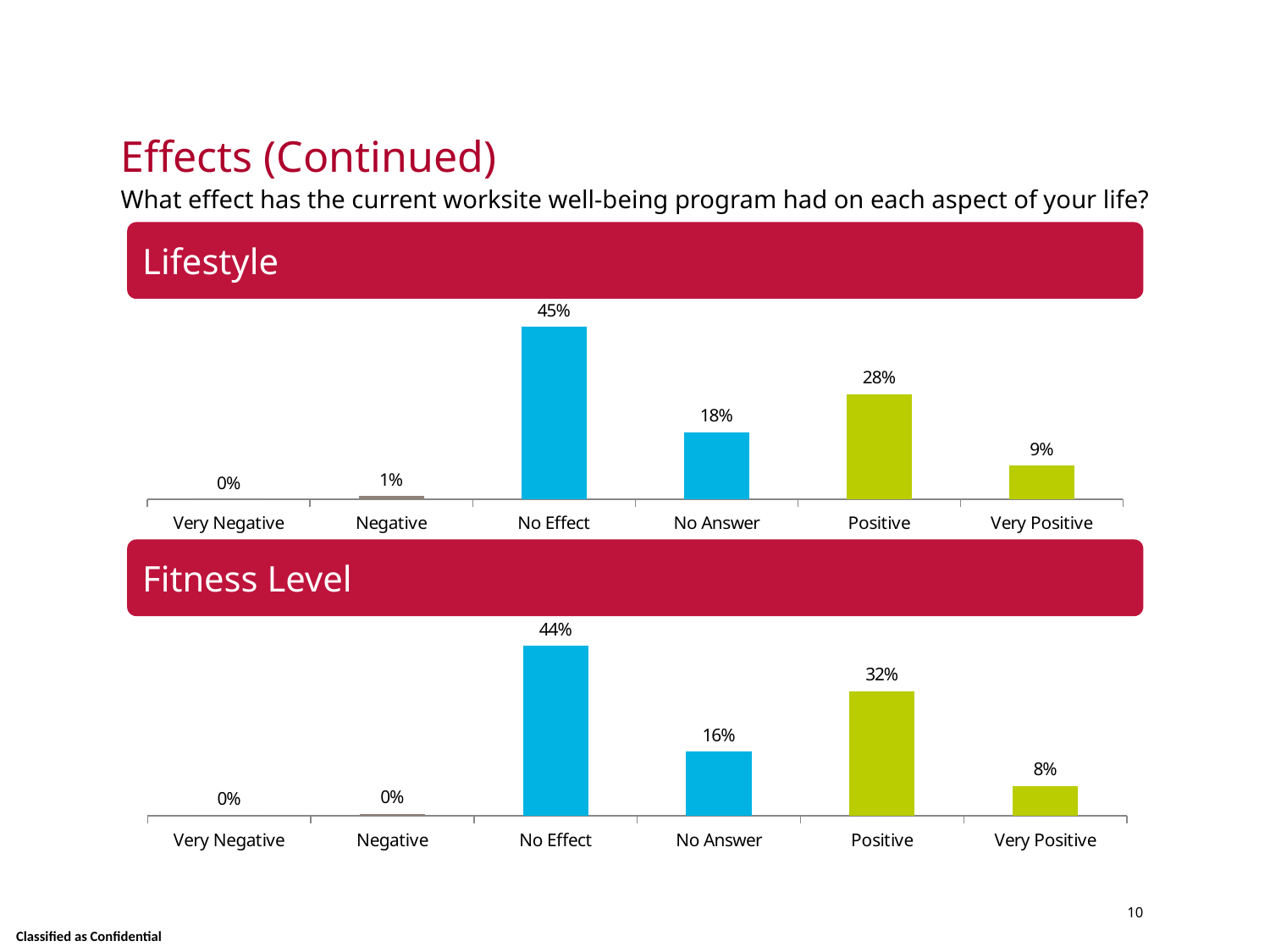
What type of chart is the Fitness Level chart? Bar chart In the Fitness Level chart, what is the value for No Answer? 16% In the Fitness Level chart, what is the difference between No Effect and Positive? 12% In the Lifestyle chart, what is the value for Very Positive? 9% In the Lifestyle chart, what is the value for Negative? 1% How many categories are shown on the x axis of the Lifestyle chart? 6 In the Fitness Level chart, which category has the lowest non-zero value? Very Positive In the Fitness Level chart, what is the value for Positive? 32% In the Lifestyle chart, which category has the highest value? No Effect In the Lifestyle chart, what is the difference between the Positive and Very Positive values? 19% In the Lifestyle chart, what percentage of respondents said the program had no effect? 45% Which is larger: the Positive value in the Lifestyle chart or the Positive value in the Fitness Level chart? Fitness Level